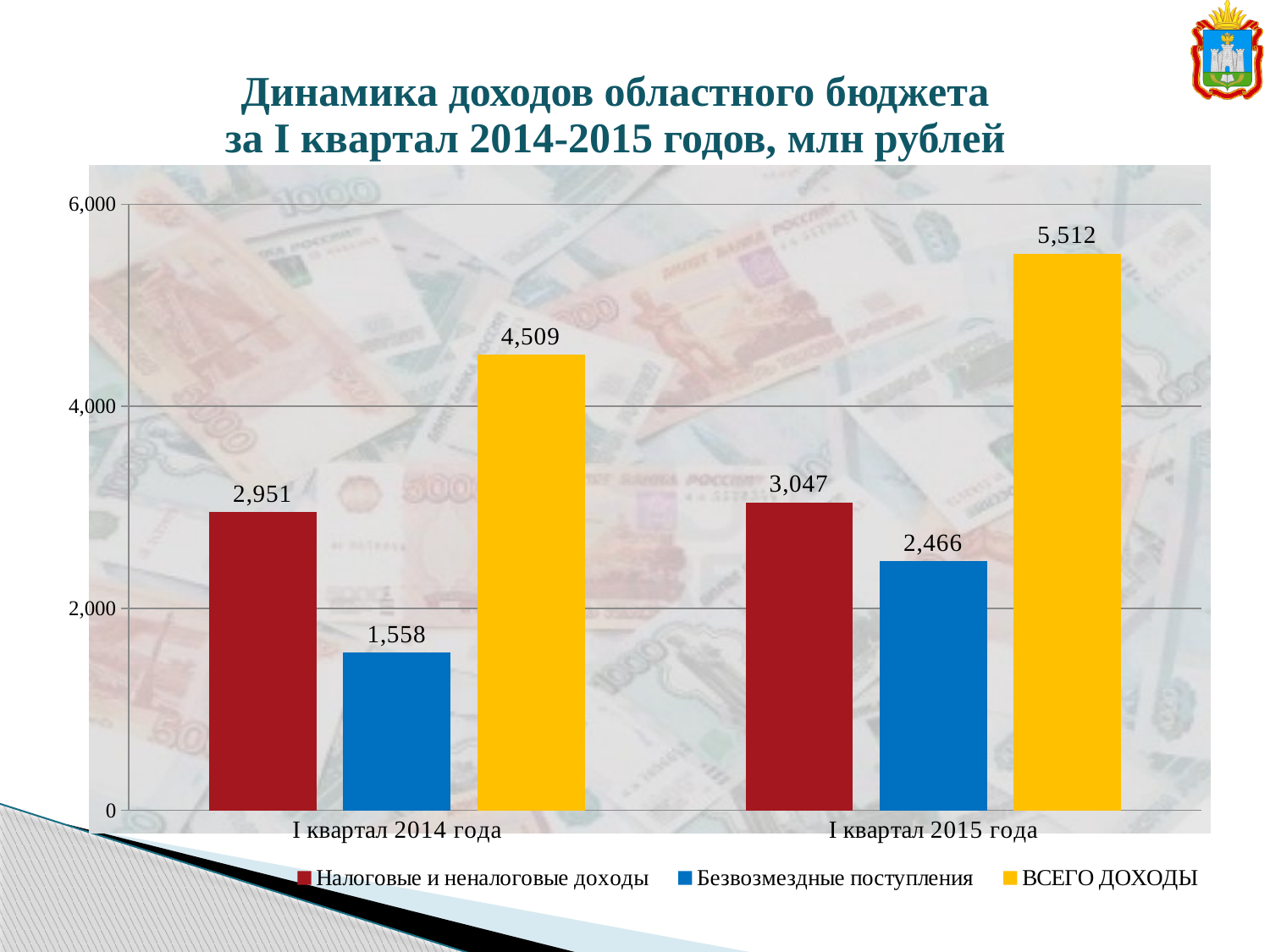
What is the value of Безвозмездные поступления for I квартал 2014 года? 1,558 What kind of chart is shown on the slide? Bar chart What is the value of ВСЕГО ДОХОДЫ for I квартал 2015 года? 5,512 Which is larger: Налоговые и неналоговые доходы for I квартал 2014 года or Безвозмездные поступления for I квартал 2015 года? Налоговые и неналоговые доходы for I квартал 2014 года How many series does the legend list? 3 What is the value of Безвозмездные поступления for I квартал 2015 года? 2,466 Does the value of Безвозмездные поступления rise or fall from I квартал 2014 года to I квартал 2015 года? Rise Which series has the lowest value for I квартал 2015 года? Безвозмездные поступления What is the value of Налоговые и неналоговые доходы for I квартал 2014 года? 2,951 Which series has the highest value for I квартал 2014 года? ВСЕГО ДОХОДЫ What is the difference between ВСЕГО ДОХОДЫ for I квартал 2015 года and I квартал 2014 года? 1,003 How many categories are shown on the x axis? 2